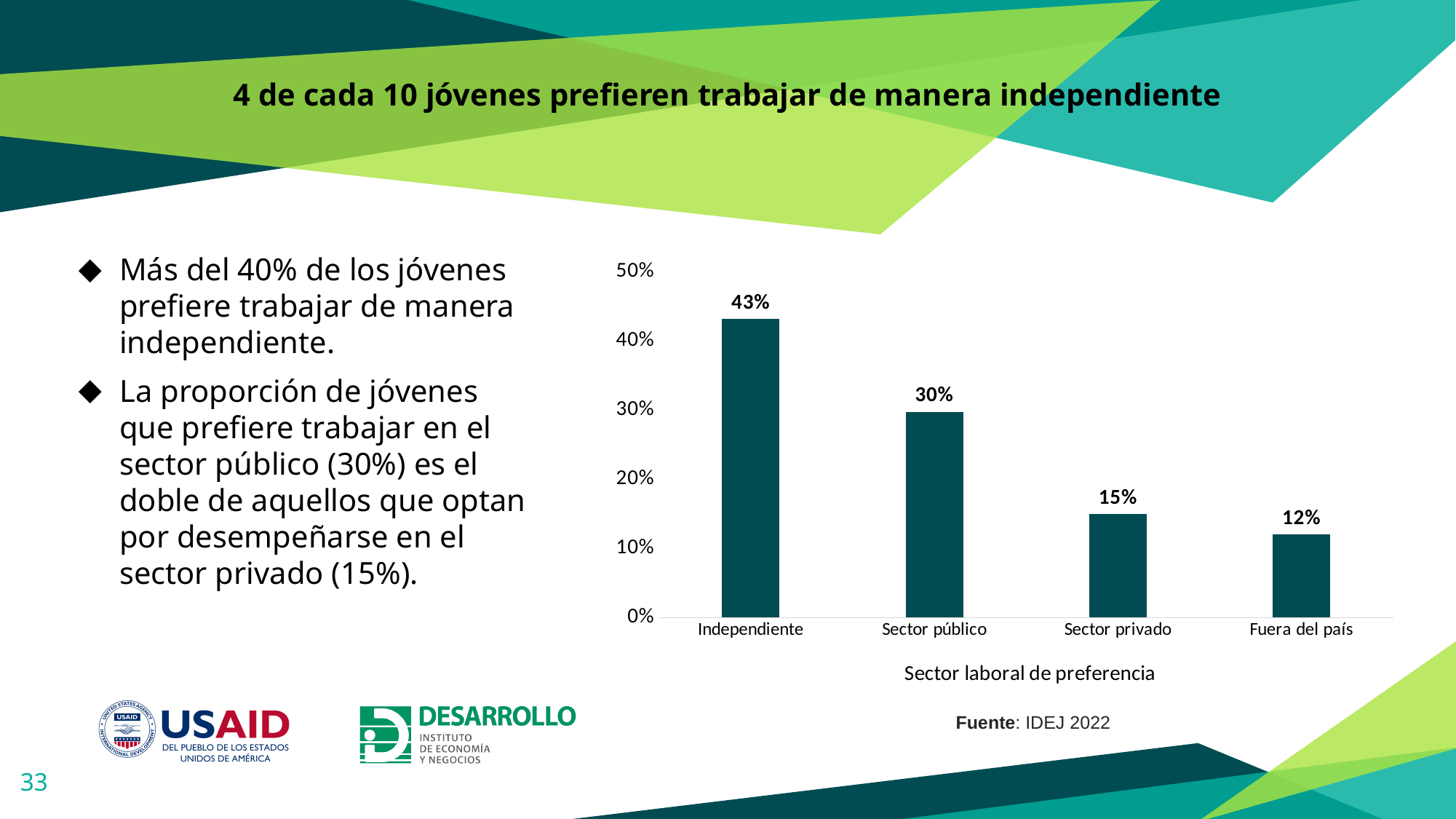
What is the value for Sector público? 30% Which category has the lowest value? Fuera del país Which is larger, the value for Sector privado or the value for Fuera del país? Sector privado How many categories are shown on the x axis? 4 What is the value for Sector privado? 15% Which category has the highest value? Independiente What is the x-axis title of the chart? Sector laboral de preferencia What is the difference between the values for Independiente and Sector público? 13% What is the value for Fuera del país? 12% What kind of chart is shown on the slide? Bar chart What is the difference between the values for Sector público and Sector privado? 15% What is the value for Independiente? 43%